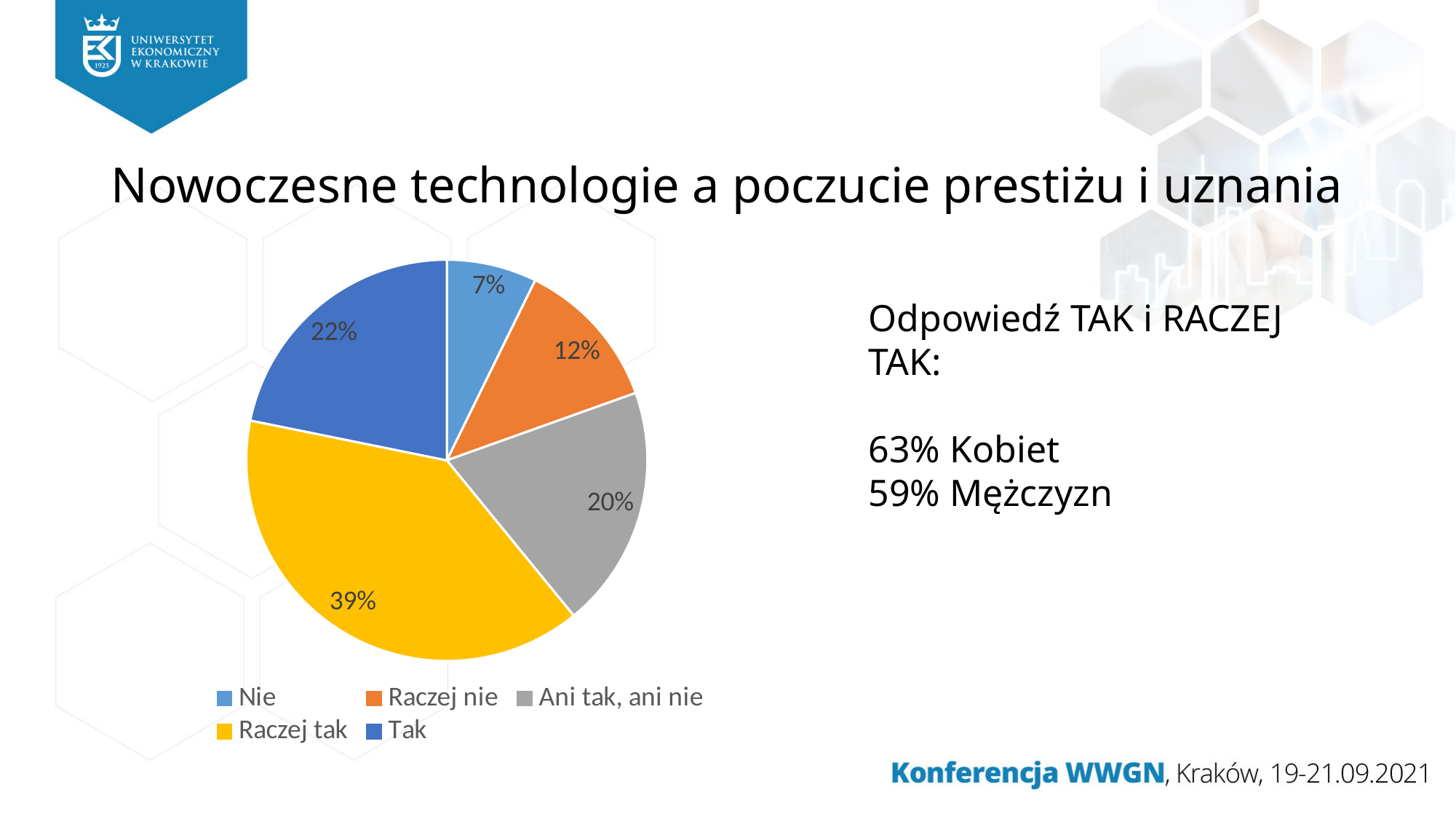
How many categories does the pie chart have? 5 What is the difference between the values for "Raczej tak" and "Tak"? 17% What is the value for "Ani tak, ani nie"? 20% What share of the pie does "Raczej tak" have? 39% Which category has the smallest slice? Nie What is the value for "Nie"? 7% Which is larger, the value for "Tak" or the value for "Ani tak, ani nie"? Tak Which category has the largest slice? Raczej tak What is the value for "Raczej nie"? 12% What colour is the "Raczej tak" slice? yellow What is the value for "Tak"? 22% What kind of chart is shown on the slide? pie chart